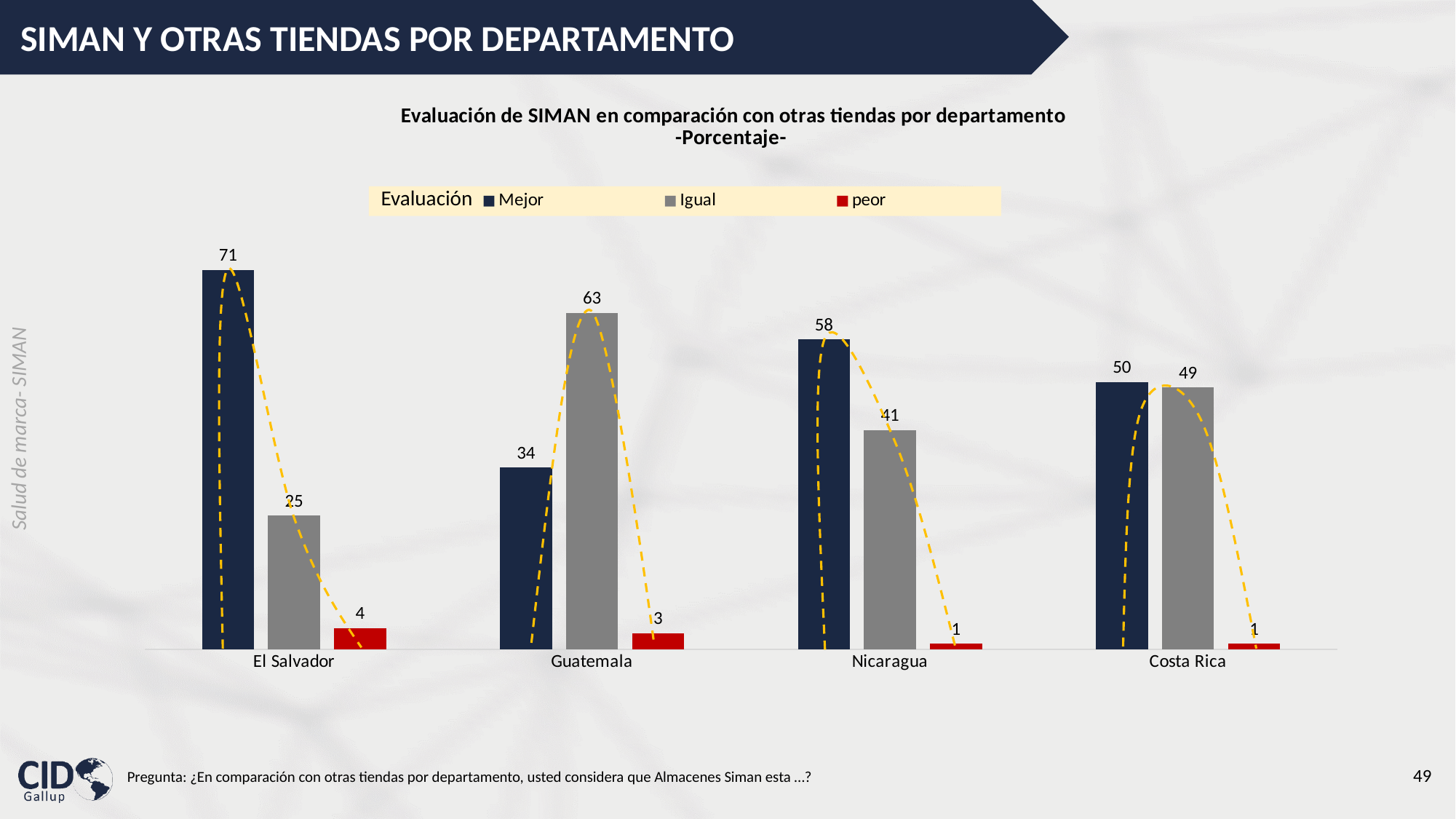
Which country has the highest value for Mejor? El Salvador What is the value for Igual in Costa Rica? 49 What is the value for peor in Nicaragua? 1 What is the difference between Mejor and Igual in Nicaragua? 17 What colour are the bars for the peor series? Red What kind of chart is shown on the slide? Bar chart How many countries are shown on the x axis? 4 Which is larger in Guatemala, Mejor or Igual? Igual What is the value for Mejor in El Salvador? 71 How many series does the legend list? 3 Which country has the lowest value for Igual? El Salvador What is the value for Igual in Guatemala? 63